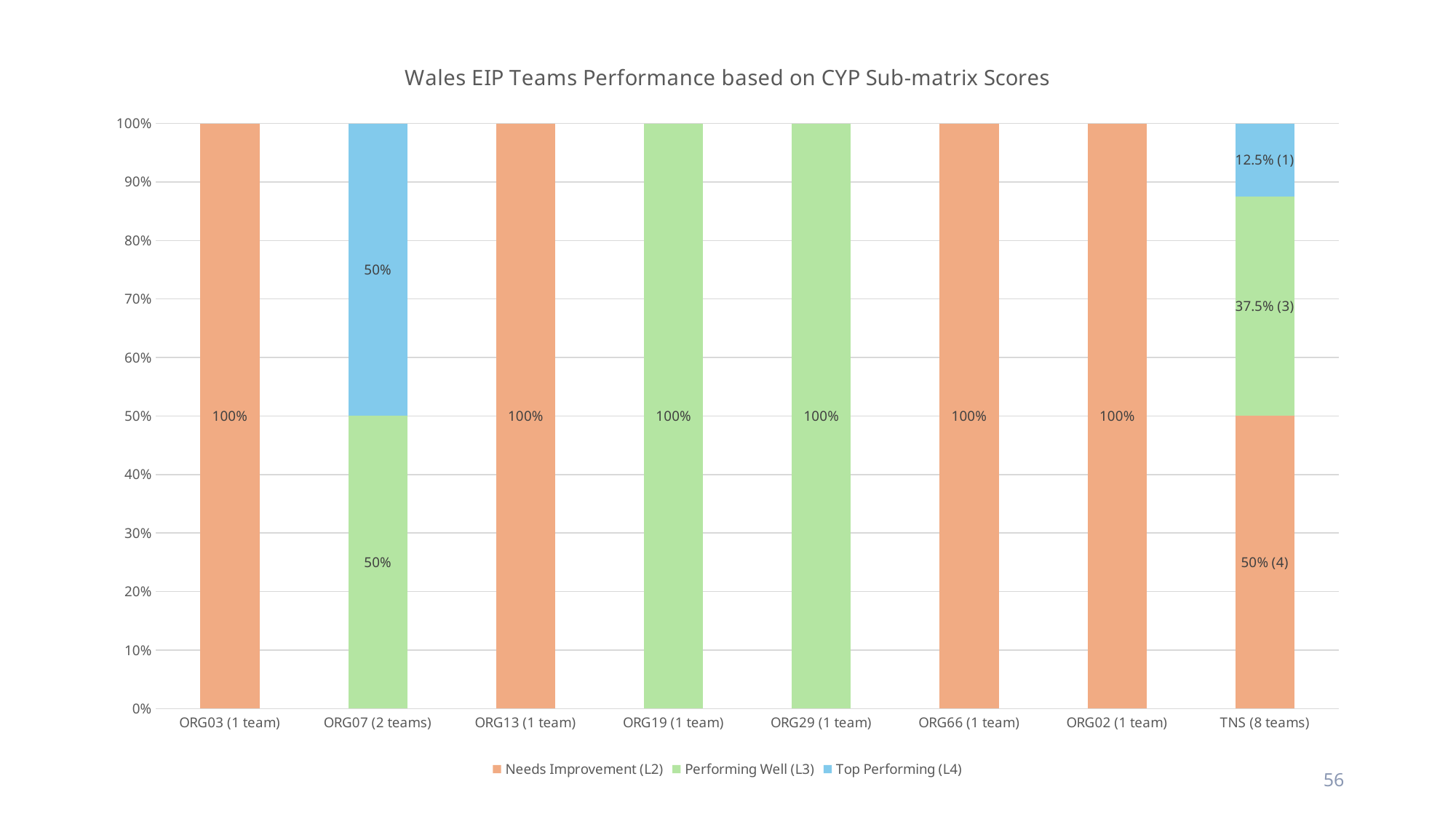
What is the difference between the Needs Improvement (L2) share and the Top Performing (L4) share for TNS (8 teams)? 37.5% How many series does the legend list? 3 What kind of chart is shown on the slide? Stacked bar chart Which is larger for TNS (8 teams): the Performing Well (L3) share or the Top Performing (L4) share? Performing Well (L3) What is the Top Performing (L4) value for ORG07 (2 teams)? 50% What is the Needs Improvement (L2) value for TNS (8 teams)? 50% (4) What is the Performing Well (L3) value for ORG19 (1 team)? 100% What is the Top Performing (L4) value for TNS (8 teams)? 12.5% (1) What is the title of the chart? Wales EIP Teams Performance based on CYP Sub-matrix Scores What is the Performing Well (L3) value for TNS (8 teams)? 37.5% (3) Which series is shown in blue in the legend? Top Performing (L4) How many categories are shown on the x axis? 8